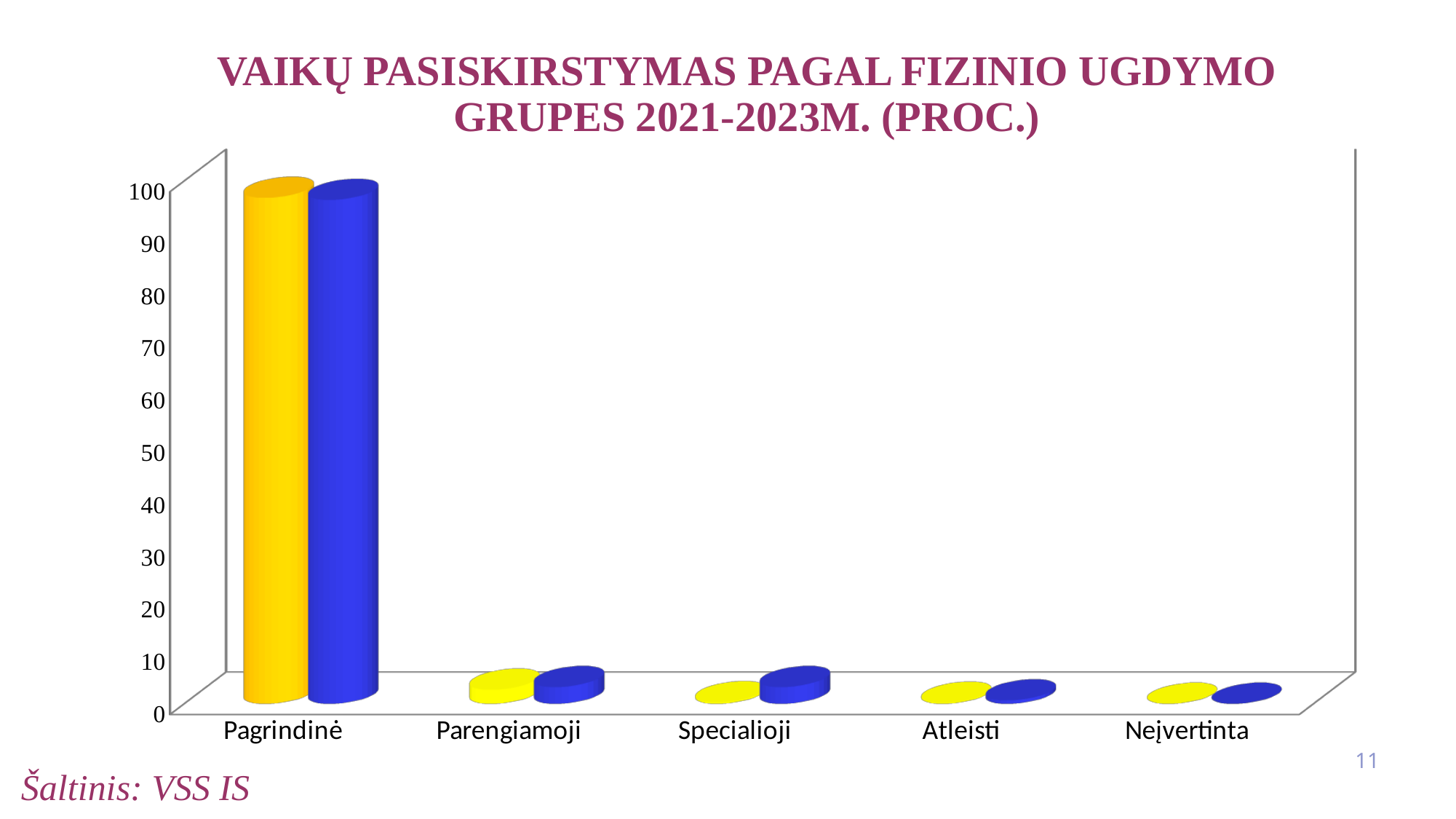
Is the value of the yellow bar for Pagrindinė greater or less than 90? greater Is the value of the yellow bar for Parengiamoji greater or less than 10? less What is the title of the chart on the slide? VAIKŲ PASISKIRSTYMAS PAGAL FIZINIO UGDYMO GRUPES 2021-2023M. (PROC.) How many categories are shown on the x axis of the chart? 5 What source is cited for the chart data on the slide? VSS IS Is the value of the yellow bar for Atleisti greater or less than 10? less Which category has the highest bars in the chart? Pagrindinė What kind of chart is shown on the slide? bar chart Which category has larger bars, Pagrindinė or Parengiamoji? Pagrindinė